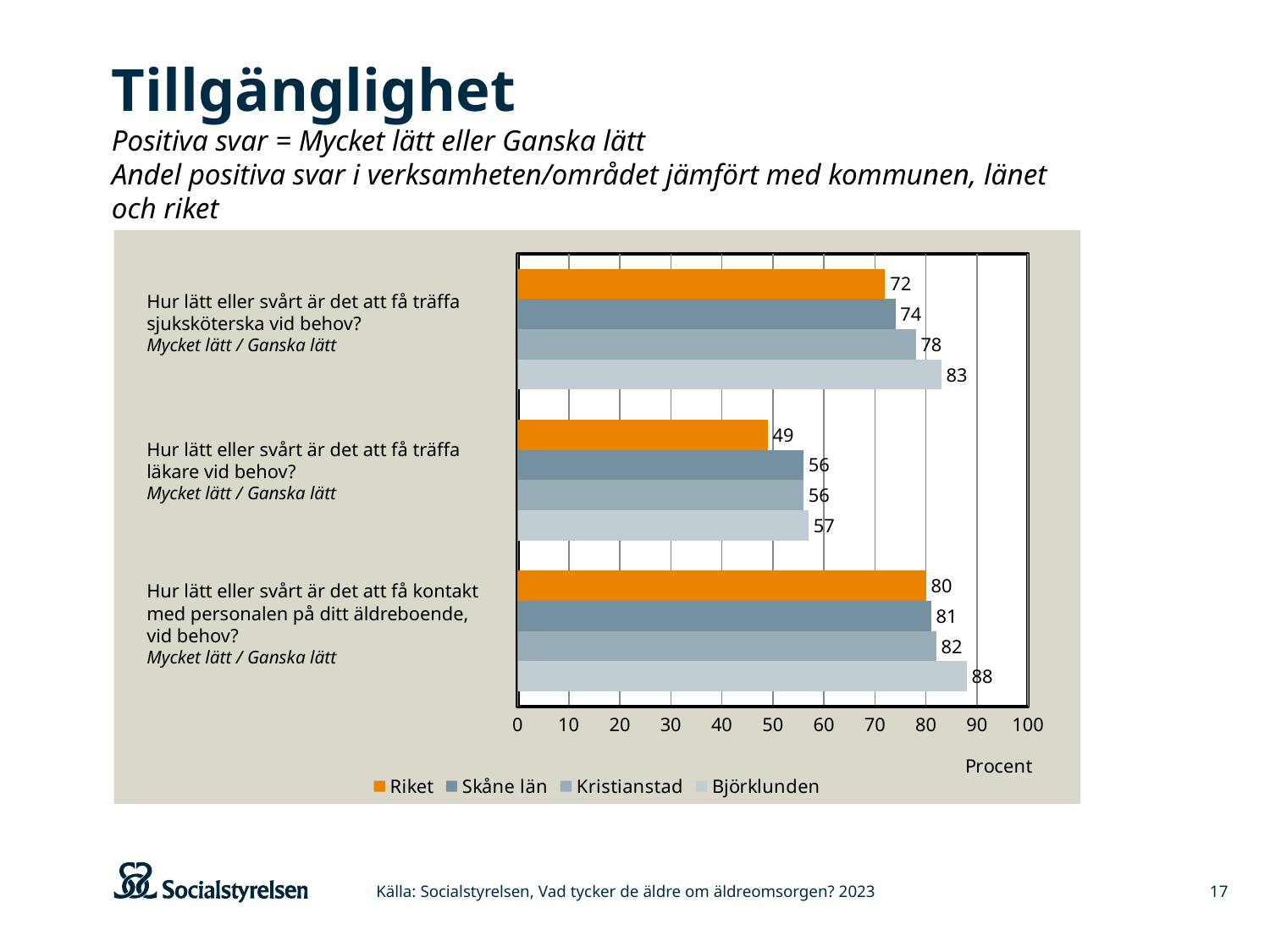
What label is shown on the horizontal axis of the chart? Procent What is the value for Riket on the question about getting to see a doctor (träffa läkare vid behov)? 49 What kind of chart is shown on the slide? bar chart Which series has the lowest value on the question about getting to see a doctor? Riket Which is larger on the nurse question: the value for Skåne län or the value for Kristianstad? Kristianstad What is the value for Björklunden on the question about getting in touch with a nurse (träffa sjuksköterska vid behov)? 83 How many series does the legend list? 4 How many question categories are plotted on the chart? 3 What is the value for Kristianstad on the question about contact with staff at the care home (kontakt med personalen)? 82 Is the value for Riket on the doctor question greater or less than 50? less What is the difference between Björklunden and Riket on the question about contact with staff at the care home? 8 Which series has the highest value on the question about contact with staff at the care home? Björklunden